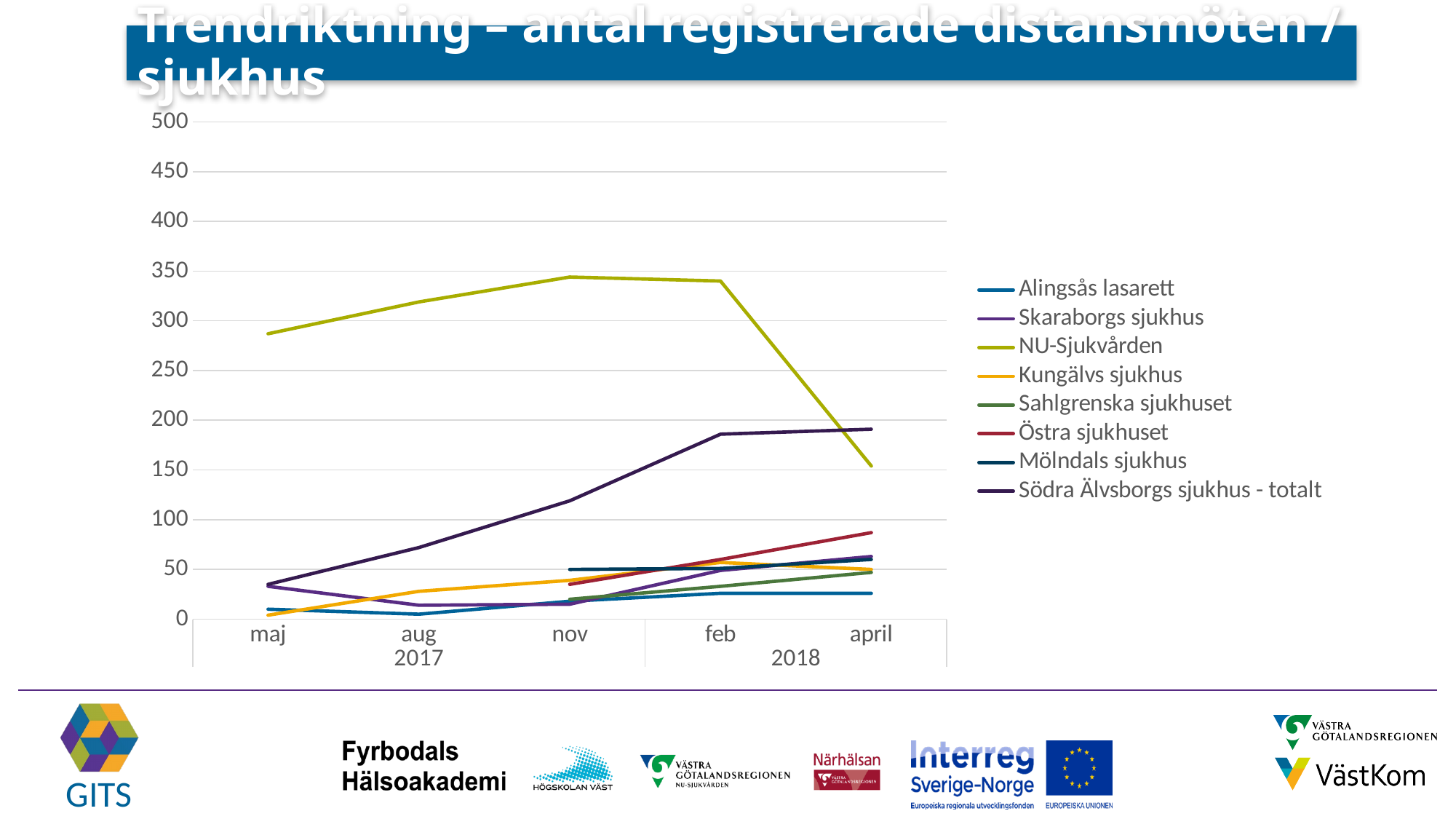
Is the value for Södra Älvsborgs sjukhus - totalt in april 2018 greater or less than 150? greater Is the value for Alingsås lasarett in aug 2017 greater or less than 50? less How many series does the legend list? 8 In april 2018, which is higher: Östra sjukhuset or Sahlgrenska sjukhuset? Östra sjukhuset In april 2018, which is higher: NU-Sjukvården or Södra Älvsborgs sjukhus - totalt? Södra Älvsborgs sjukhus - totalt Is the value for NU-Sjukvården in april 2018 greater or less than 200? less Does the line for Södra Älvsborgs sjukhus - totalt rise or fall from maj 2017 to april 2018? Rise Which series has the highest value in nov 2017? NU-Sjukvården What kind of chart is shown on the slide? Line chart Does the line for NU-Sjukvården rise or fall between feb 2018 and april 2018? Fall How many time points are plotted along the x axis? 5